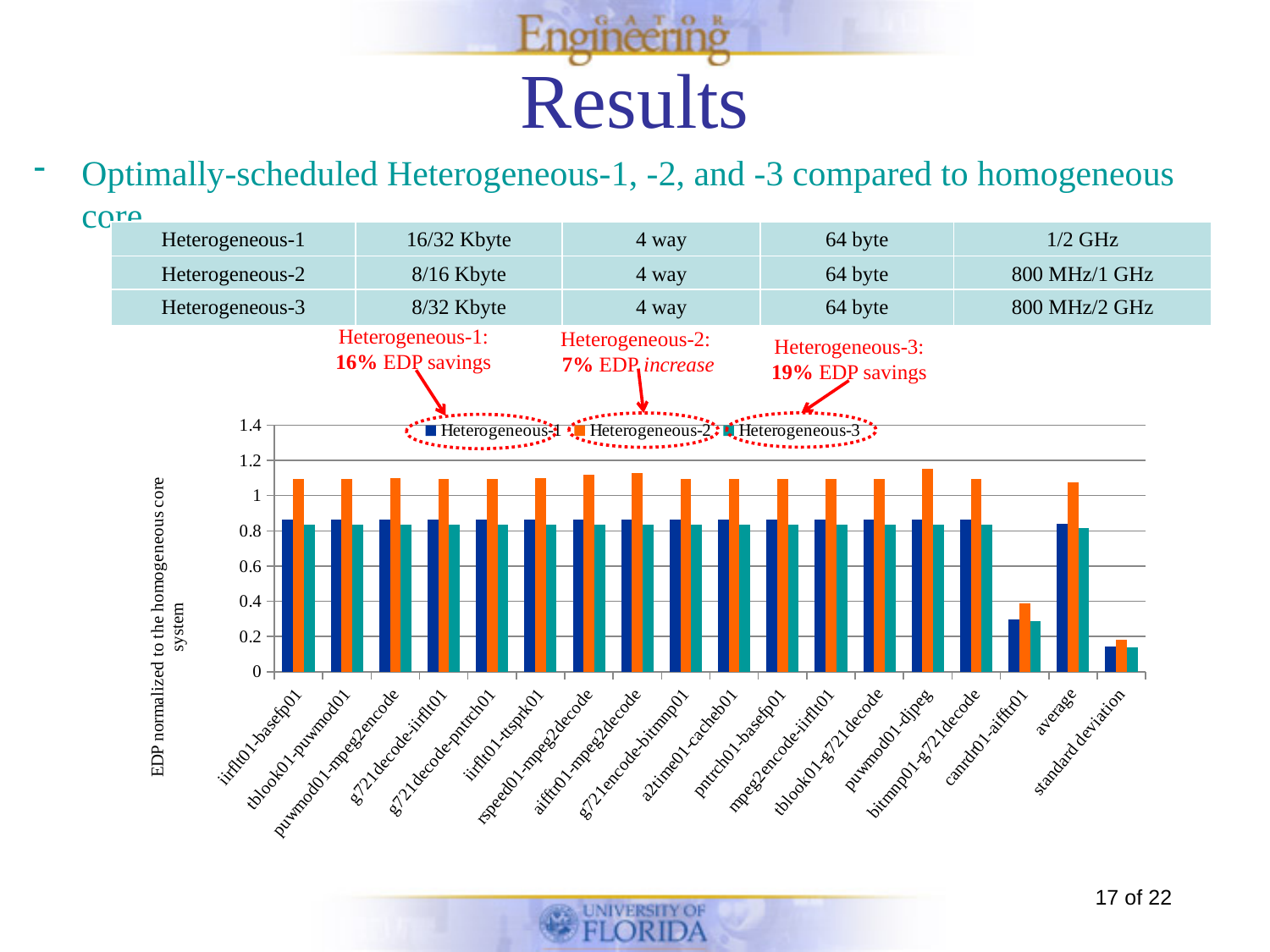
Is the Heterogeneous-1 value for standard deviation greater or less than 0.2? less For canrdr01-aifftr01, which is larger: the Heterogeneous-1 value or the Heterogeneous-2 value? Heterogeneous-2 Which category has the highest Heterogeneous-2 value? puwmod01-djpeg Is the Heterogeneous-1 value for canrdr01-aifftr01 greater or less than 0.2? greater What is the label on the chart's y axis? EDP normalized to the homogeneous core system Is the Heterogeneous-2 value for iirflt01-basefp01 greater or less than 1? greater Which category has the lowest Heterogeneous-2 value? standard deviation For average, which is larger: the Heterogeneous-2 value or the Heterogeneous-3 value? Heterogeneous-2 What kind of chart is shown on the slide? bar chart How many categories are plotted along the x axis of the chart? 18 How many series does the chart's legend list? 3